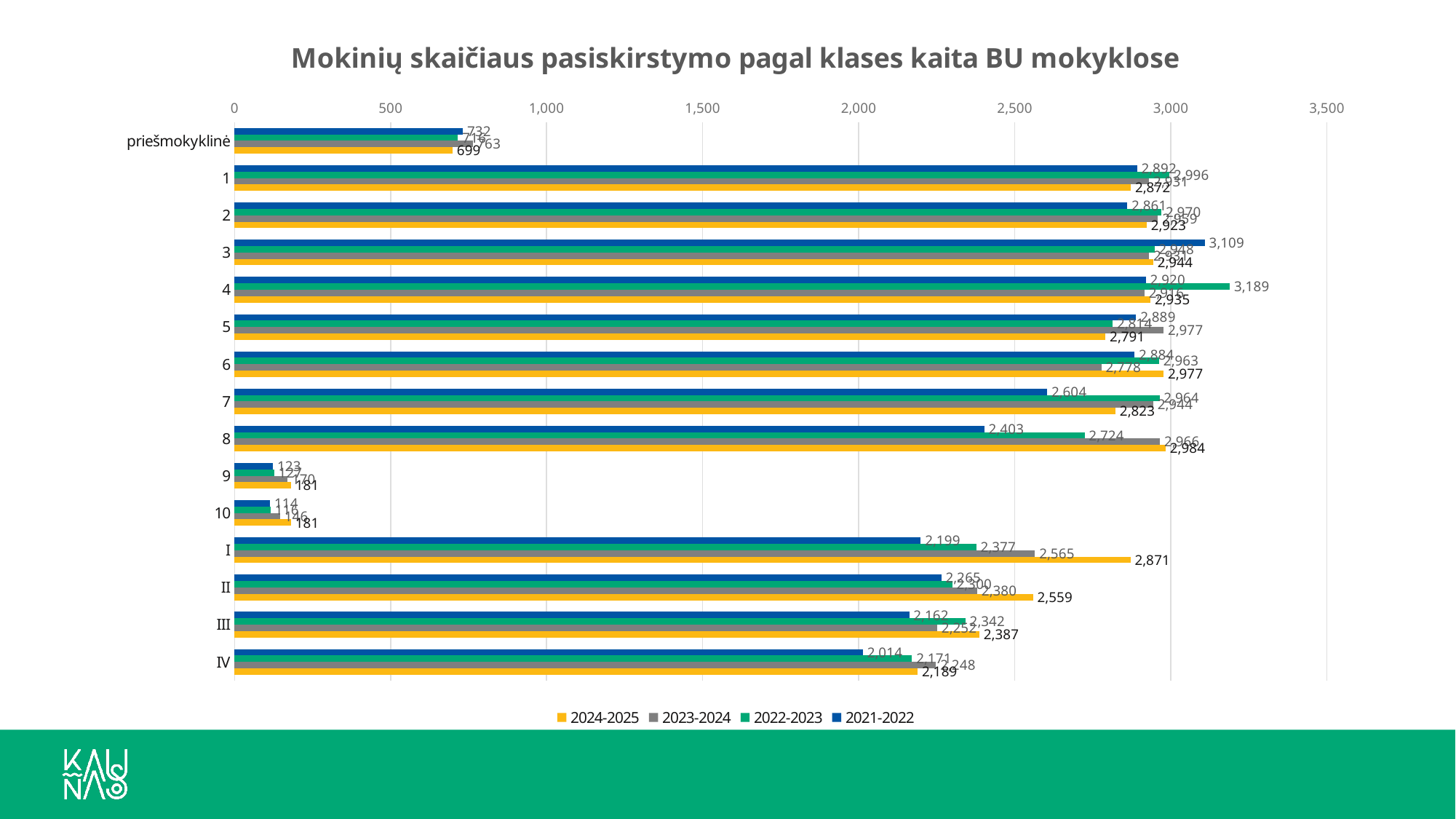
Is the 2021-2022 value for class 8 greater or less than 2,500? less How many series does the legend list? 4 What kind of chart is shown on the slide? bar chart For priešmokyklinė, which is larger: the 2023-2024 value or the 2024-2025 value? 2023-2024 What colour represents the 2024-2025 series in the legend? yellow What is the 2024-2025 value for class I? 2,871 Which series has the highest value for class I? 2024-2025 What is the 2024-2025 value for class 9? 181 What is the difference between the 2024-2025 and 2021-2022 values for class I? 672 What is the 2021-2022 value for class 3? 3,109 How many class categories are shown on the chart? 15 What is the 2022-2023 value for class 4? 3,189